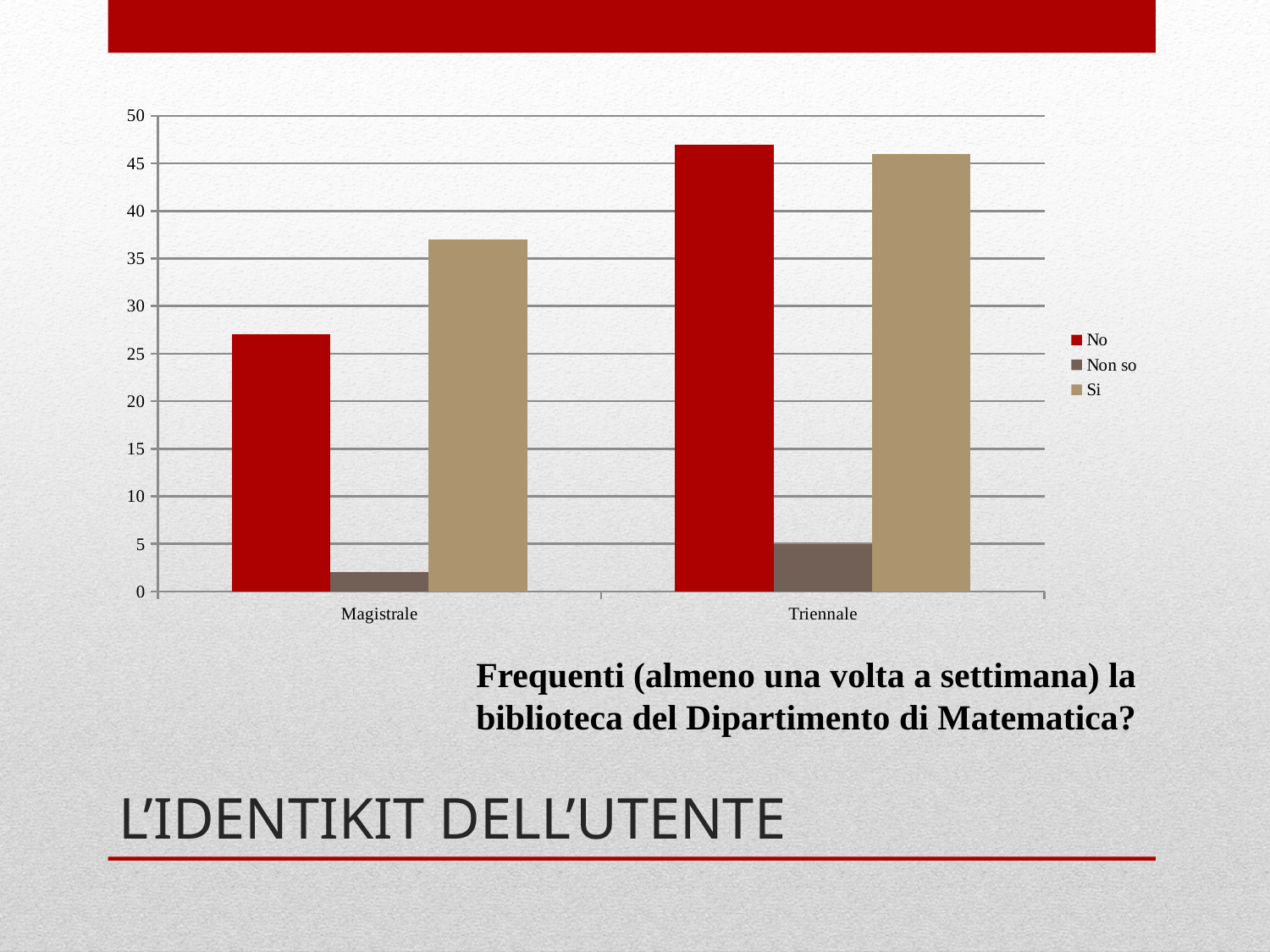
What is the value of the "Non so" bar for Triennale? 5 For Magistrale, which is larger: the "No" bar or the "Si" bar? Si Is the value of the "No" bar for Triennale greater or less than 45? greater How many categories are shown on the x axis? 2 What kind of chart is shown on the slide? bar chart Is the value of the "Non so" bar for Magistrale greater or less than 5? less Is the value of the "Si" bar for Magistrale greater or less than 35? greater Which bar is the lowest in the whole chart? Non so for Magistrale How many series does the legend list? 3 Which category has the larger "No" bar, Magistrale or Triennale? Triennale What are the three entries listed in the legend? No, Non so, Si